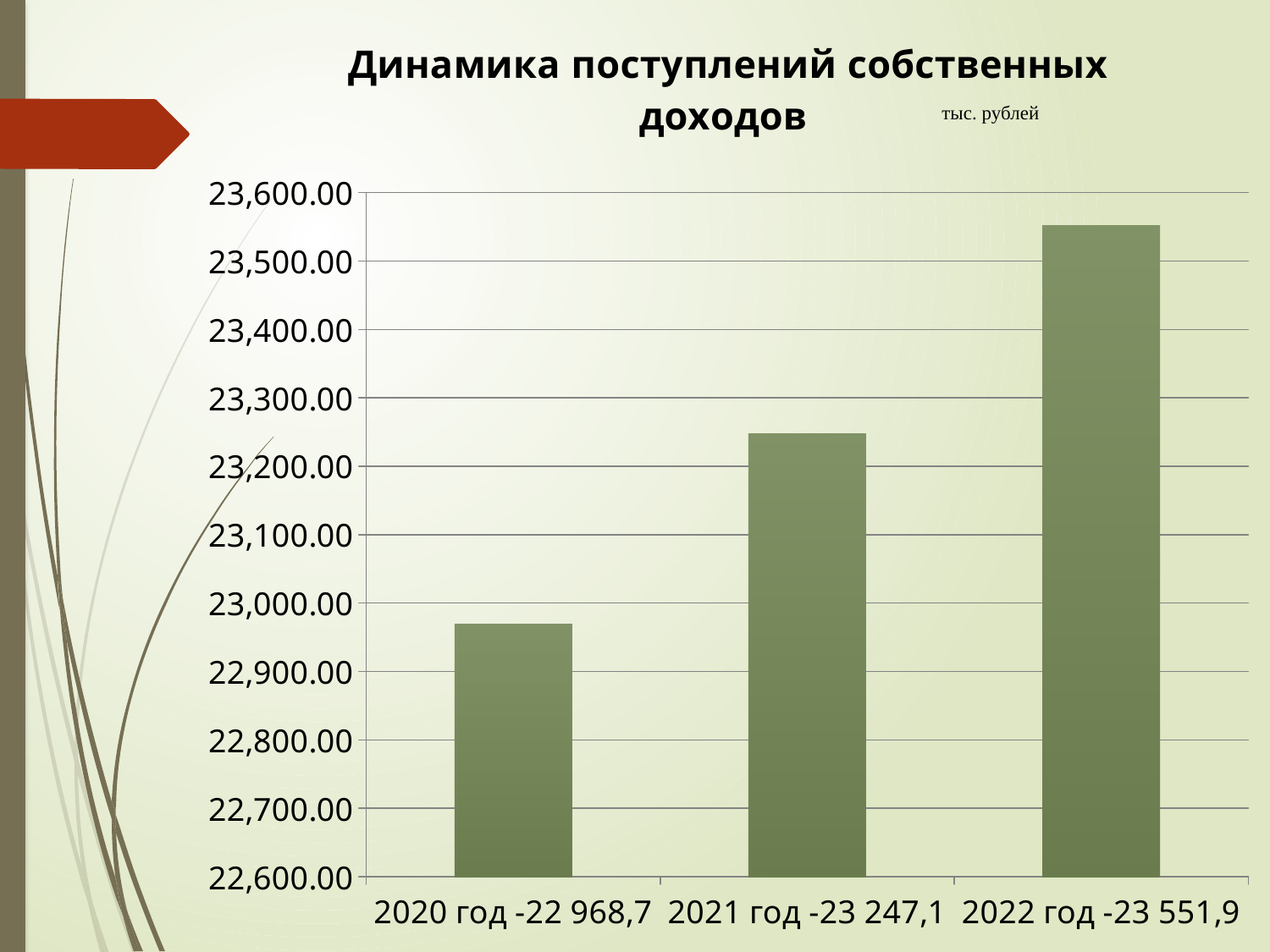
How many bars (years) are shown on the chart? 3 What is the difference between the values for 2022 год and 2021 год? 304,8 What is the title of the chart? Динамика поступлений собственных доходов What is the value shown for 2022 год? 23 551,9 Do the values rise or fall from 2020 год to 2022 год? rise Is the value for 2020 год greater or less than 23,000.00? less What is the value shown for 2021 год? 23 247,1 What is the value shown for 2020 год? 22 968,7 In what units are the values on the chart expressed, according to the note next to the title? тыс. рублей What type of chart is shown on the slide? bar chart Which year has the highest value? 2022 год Which year has the lowest value? 2020 год